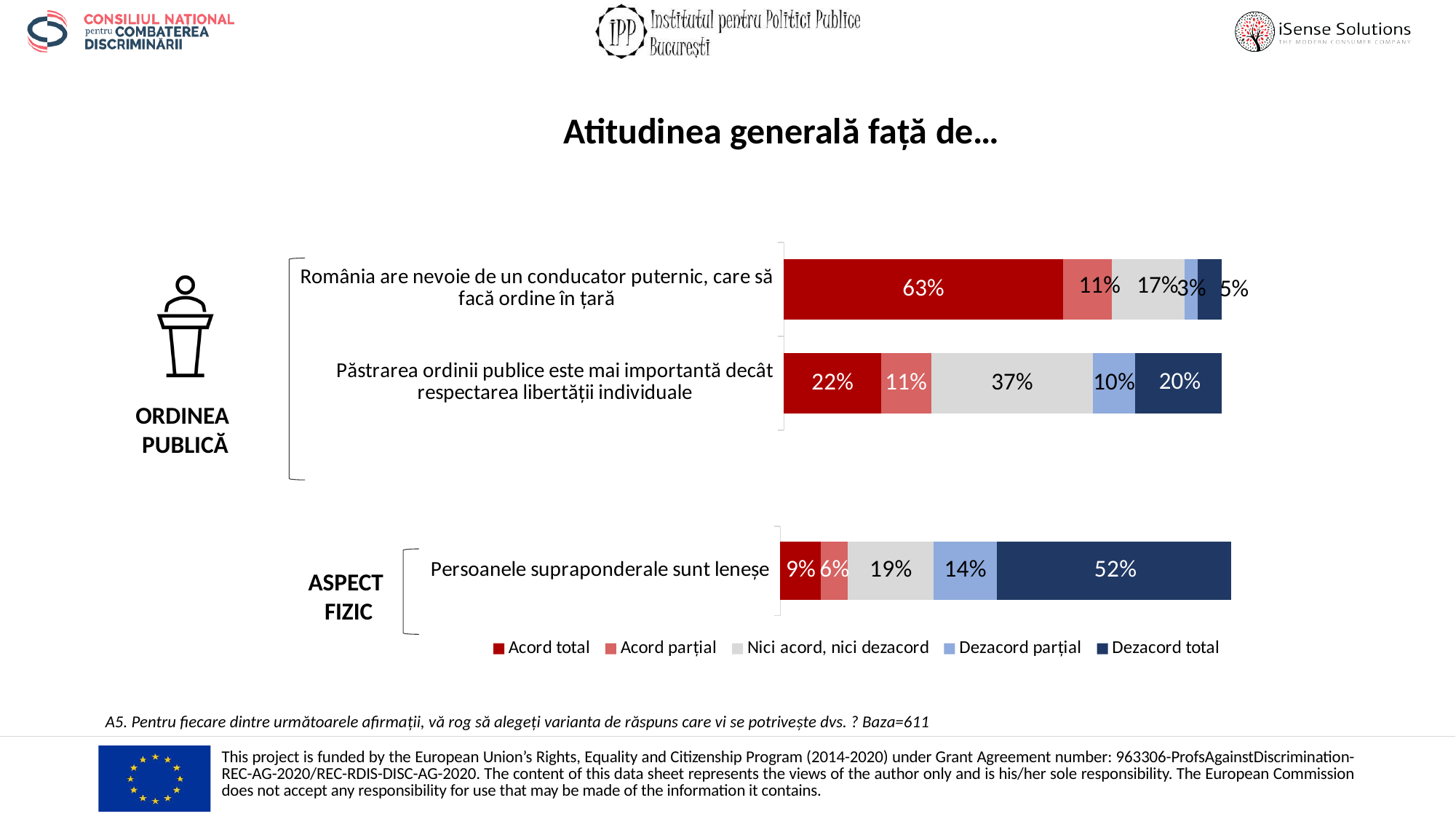
Which colour represents 'Acord total' in the legend? Dark red In the ORDINEA PUBLICĂ chart, what percentage chose 'Acord total' for the statement 'România are nevoie de un conducator puternic, care să facă ordine în țară'? 63% In the ORDINEA PUBLICĂ chart, what is the difference between the 'Acord total' shares for the two statements? 41% What kind of chart is used on this slide? Stacked bar chart In the ORDINEA PUBLICĂ chart, which statement has the larger 'Dezacord total' share? Păstrarea ordinii publice este mai importantă decât respectarea libertății individuale In the ASPECT FIZIC chart, which response category has the highest share for 'Persoanele supraponderale sunt leneșe'? Dezacord total How many series does the legend list? 5 In the ORDINEA PUBLICĂ chart, what percentage chose 'Nici acord, nici dezacord' for 'Păstrarea ordinii publice este mai importantă decât respectarea libertății individuale'? 37% In the ASPECT FIZIC chart, what percentage chose 'Dezacord total' for 'Persoanele supraponderale sunt leneșe'? 52% In the ORDINEA PUBLICĂ chart, which response category has the lowest share for 'România are nevoie de un conducator puternic, care să facă ordine în țară'? Dezacord parțial How many statements are plotted in the ORDINEA PUBLICĂ chart? 2 In the ASPECT FIZIC chart, what percentage chose 'Acord parțial' for 'Persoanele supraponderale sunt leneșe'? 6%